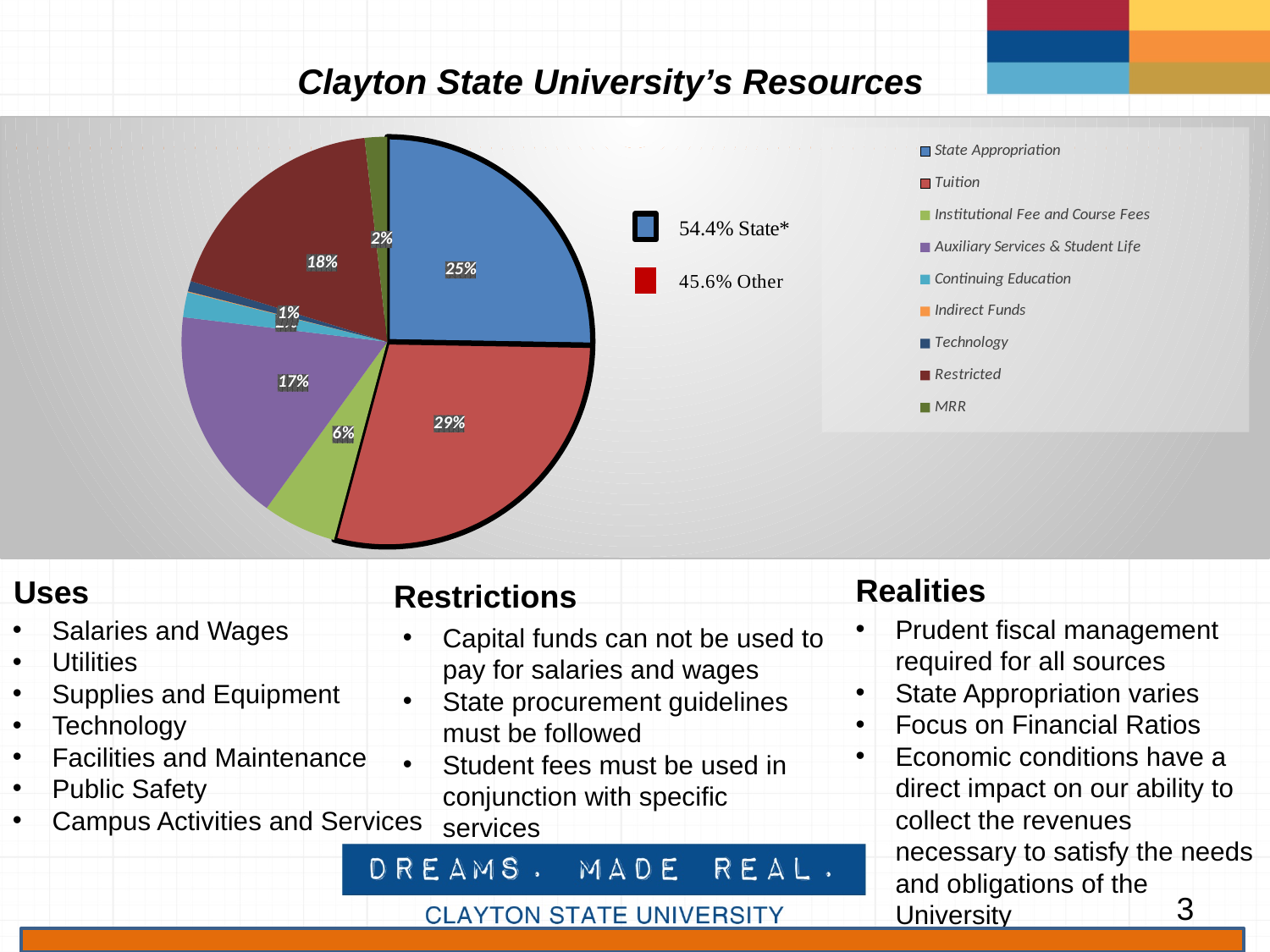
What share of the pie does Tuition represent? 29% What share of the pie does Institutional Fee and Course Fees represent? 6% What share of the pie does MRR represent? 2% What kind of chart is shown on the slide? pie chart Which is larger, the State Appropriation slice or the Restricted slice? State Appropriation What is the title shown above the pie chart? Clayton State University's Resources How many categories does the legend of the pie chart list? 9 Which category has the largest slice of the pie? Tuition How many percentage points larger is the Tuition slice than the State Appropriation slice? 4%